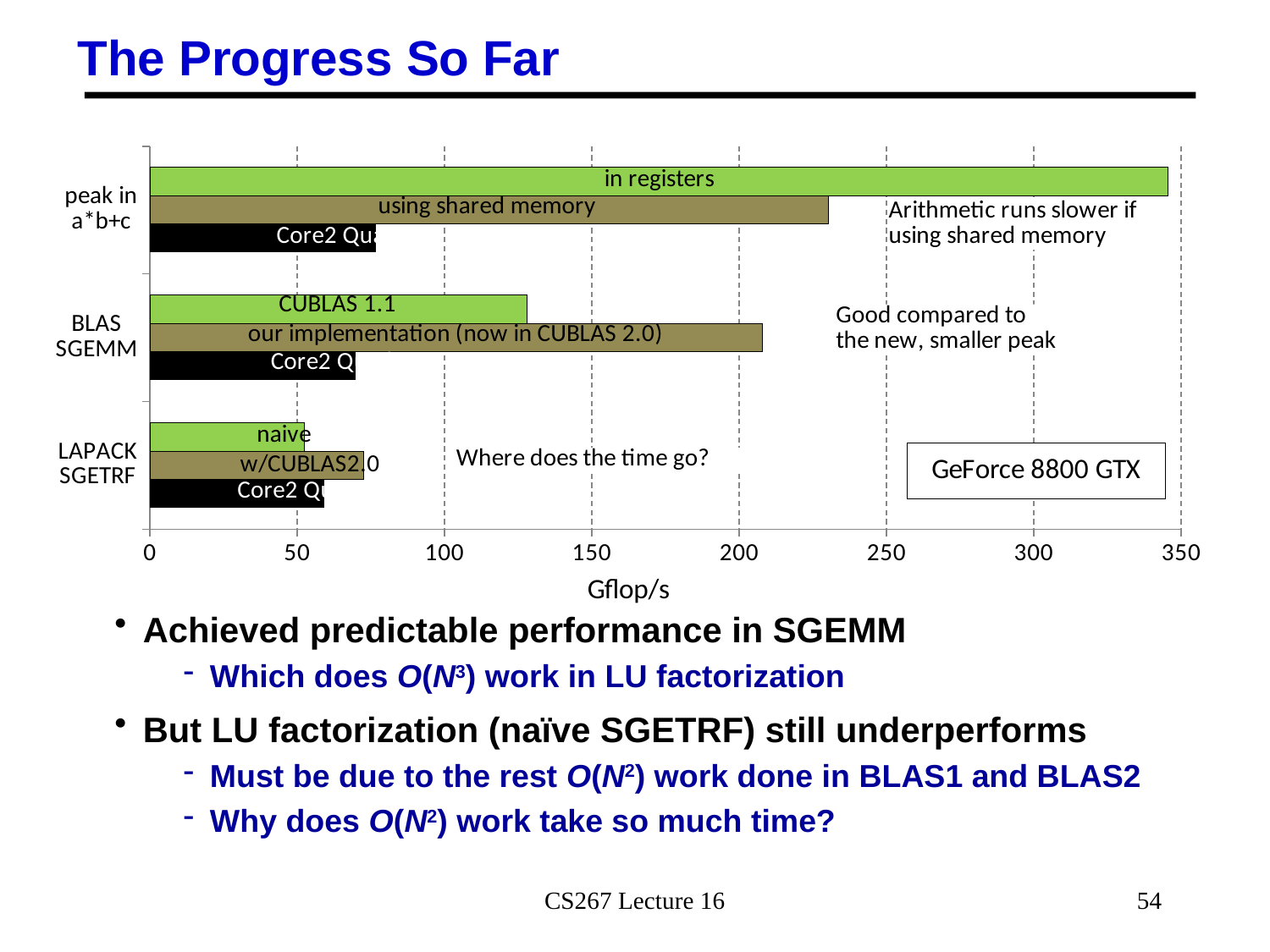
Is the value for 'naive' in the LAPACK SGETRF category greater or less than 100? less Which is larger, the value for 'CUBLAS 1.1' or the value for 'our implementation (now in CUBLAS 2.0)'? our implementation (now in CUBLAS 2.0) How many categories are shown on the vertical axis of the chart? 3 What kind of chart is shown on the slide? bar chart Is the value for 'in registers' greater or less than 300? greater Is the value for 'our implementation (now in CUBLAS 2.0)' greater or less than 200? greater Which bar in the chart is the longest? in registers Which is larger, the value for 'in registers' or the value for 'using shared memory'? in registers Which bar in the chart is the shortest? naive What is the label of the horizontal axis of the chart? Gflop/s